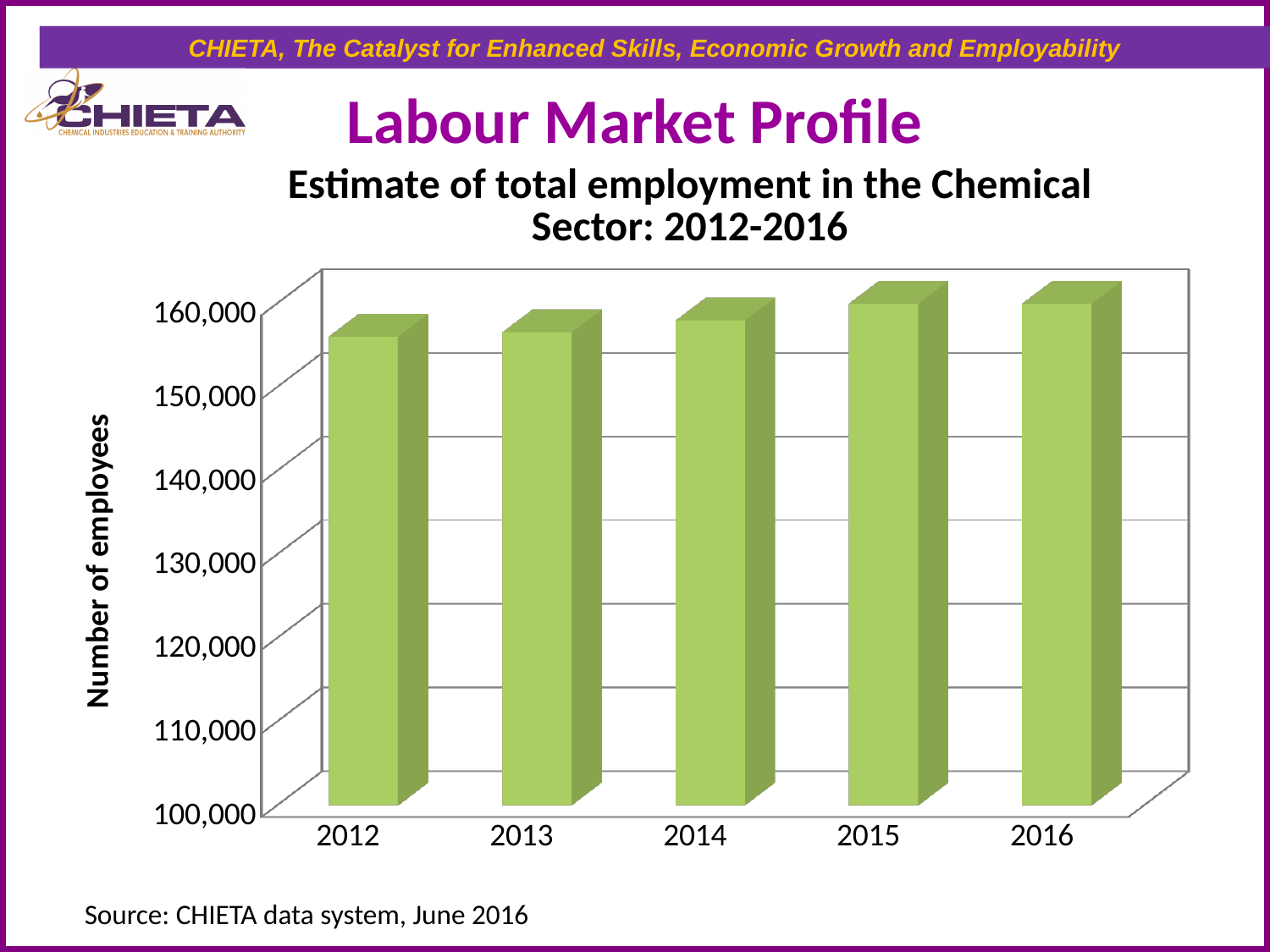
How many years are shown on the x axis of the chart? 5 What kind of chart is shown on the slide? bar chart What is the title of the chart? Estimate of total employment in the Chemical Sector: 2012-2016 Is the value for 2013 greater or less than 140,000? greater What is the label on the vertical axis of the chart? Number of employees Is the value for 2012 greater or less than 160,000? less Do the employment values generally rise or fall from 2012 to 2016? rise Is the value for 2012 greater or less than 150,000? greater Which is larger, the value for 2012 or the value for 2015? 2015 Which is larger, the value for 2013 or the value for 2016? 2016